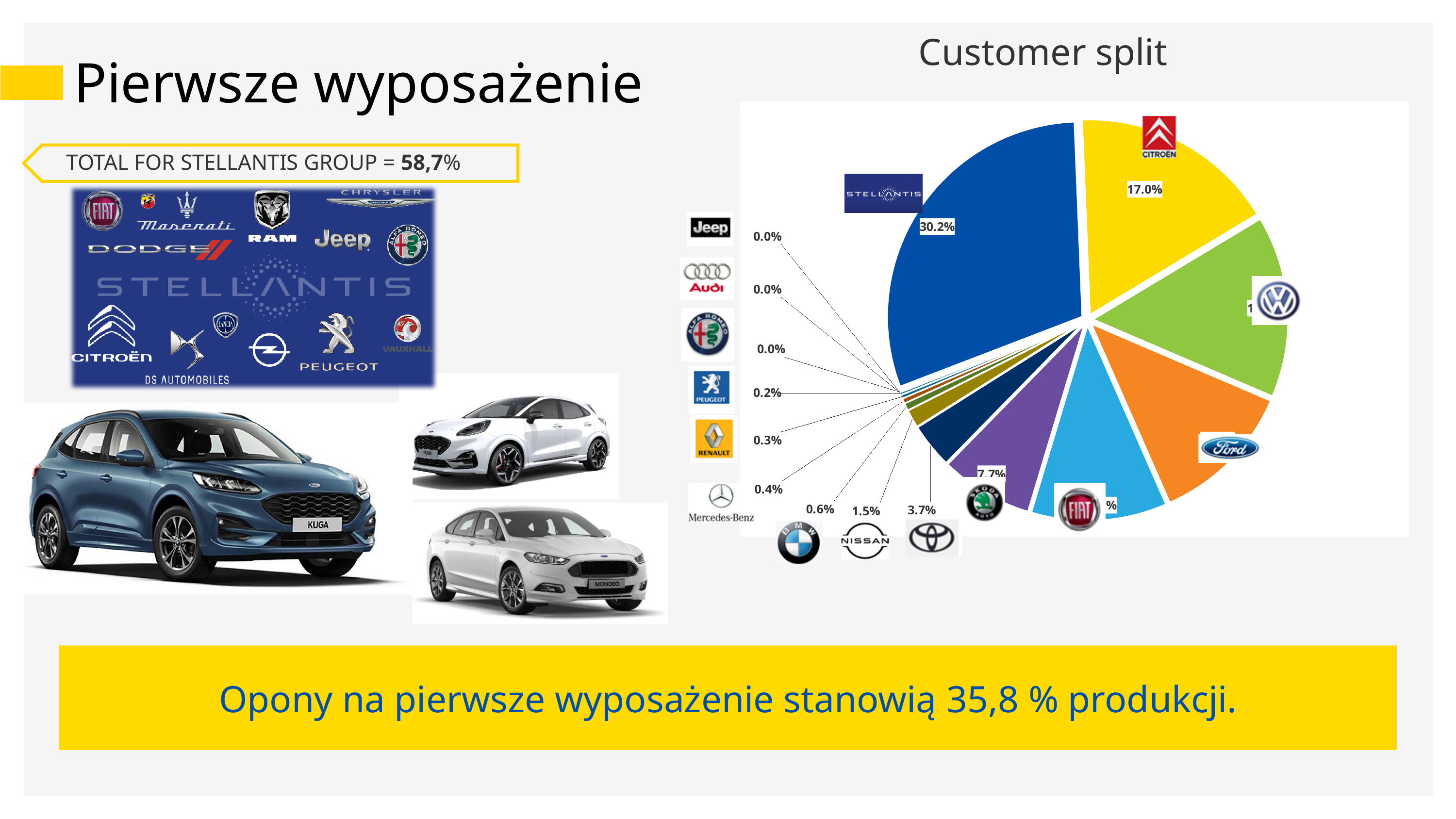
In the Customer split pie chart, what share is labelled for Citroën? 17.0% In the Customer split pie chart, how much larger is the Stellantis share than the Citroën share? 13.2% In the Customer split pie chart, what share is labelled for Mercedes-Benz? 0.4% In the Customer split pie chart, what share is labelled for BMW? 0.6% What is the title of the chart on the right side of the slide? Customer split In the Customer split pie chart, what share is labelled for Skoda? 7.7% What type of chart is shown under the title "Customer split"? pie chart In the Customer split pie chart, what share is labelled for Stellantis? 30.2% In the Customer split pie chart, which customer has the largest slice? Stellantis In the Customer split pie chart, which has the larger share, Toyota or Nissan? Toyota In the Customer split pie chart, what share is labelled for Nissan? 1.5% In the Customer split pie chart, what share is labelled for Toyota? 3.7%